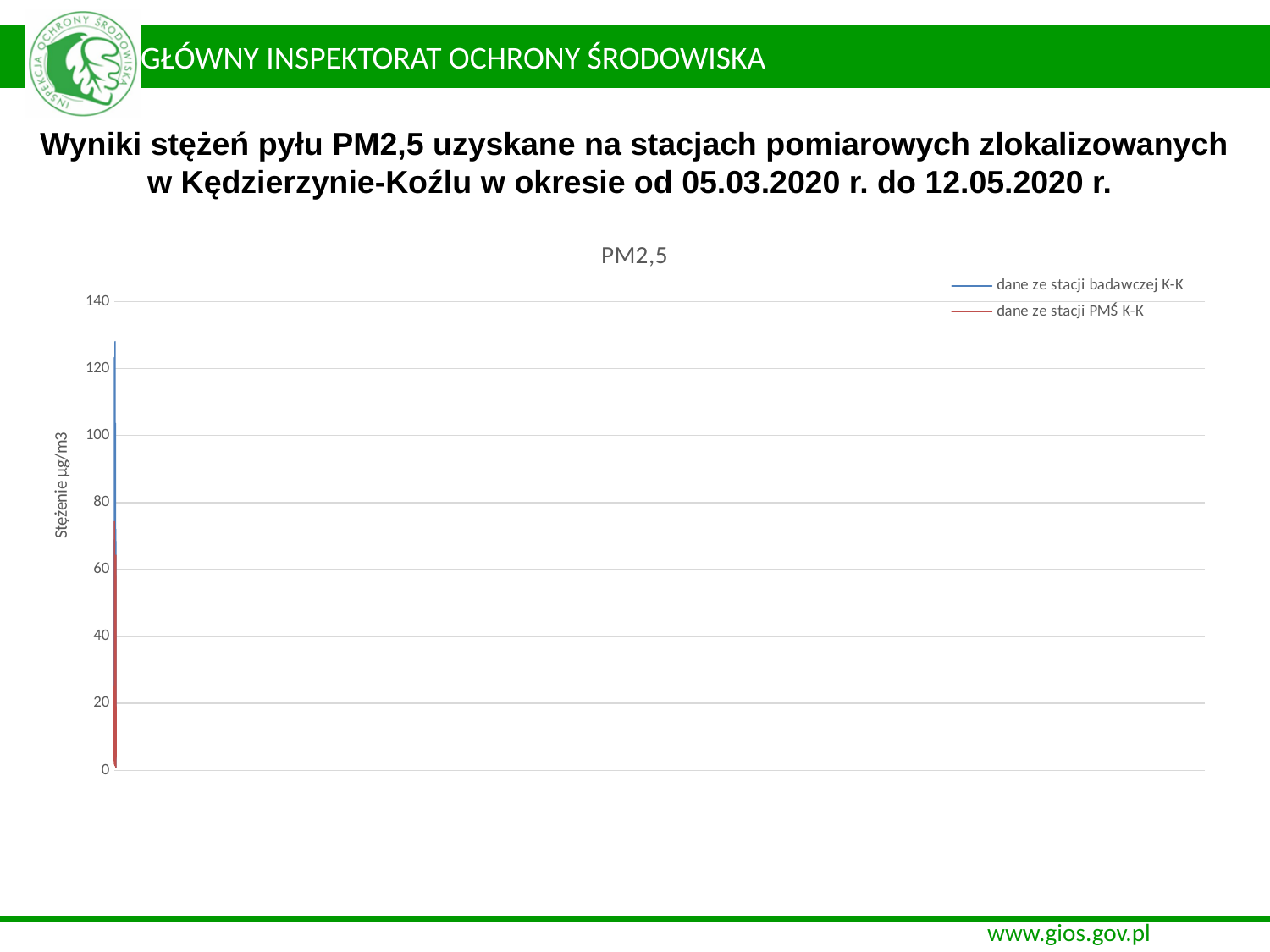
Is the peak value of the 'dane ze stacji badawczej K-K' series greater or less than 140? less Is the peak value of the 'dane ze stacji PMŚ K-K' series greater or less than 100? less What kind of chart is shown on the slide? line chart Which series reaches the higher peak value, 'dane ze stacji badawczej K-K' or 'dane ze stacji PMŚ K-K'? dane ze stacji badawczej K-K What are the two series named in the legend of the PM2,5 chart? dane ze stacji badawczej K-K; dane ze stacji PMŚ K-K How many series does the legend of the PM2,5 chart list? 2 What is the title printed above the chart? PM2,5 Is the peak value of the 'dane ze stacji badawczej K-K' series greater or less than 100? greater